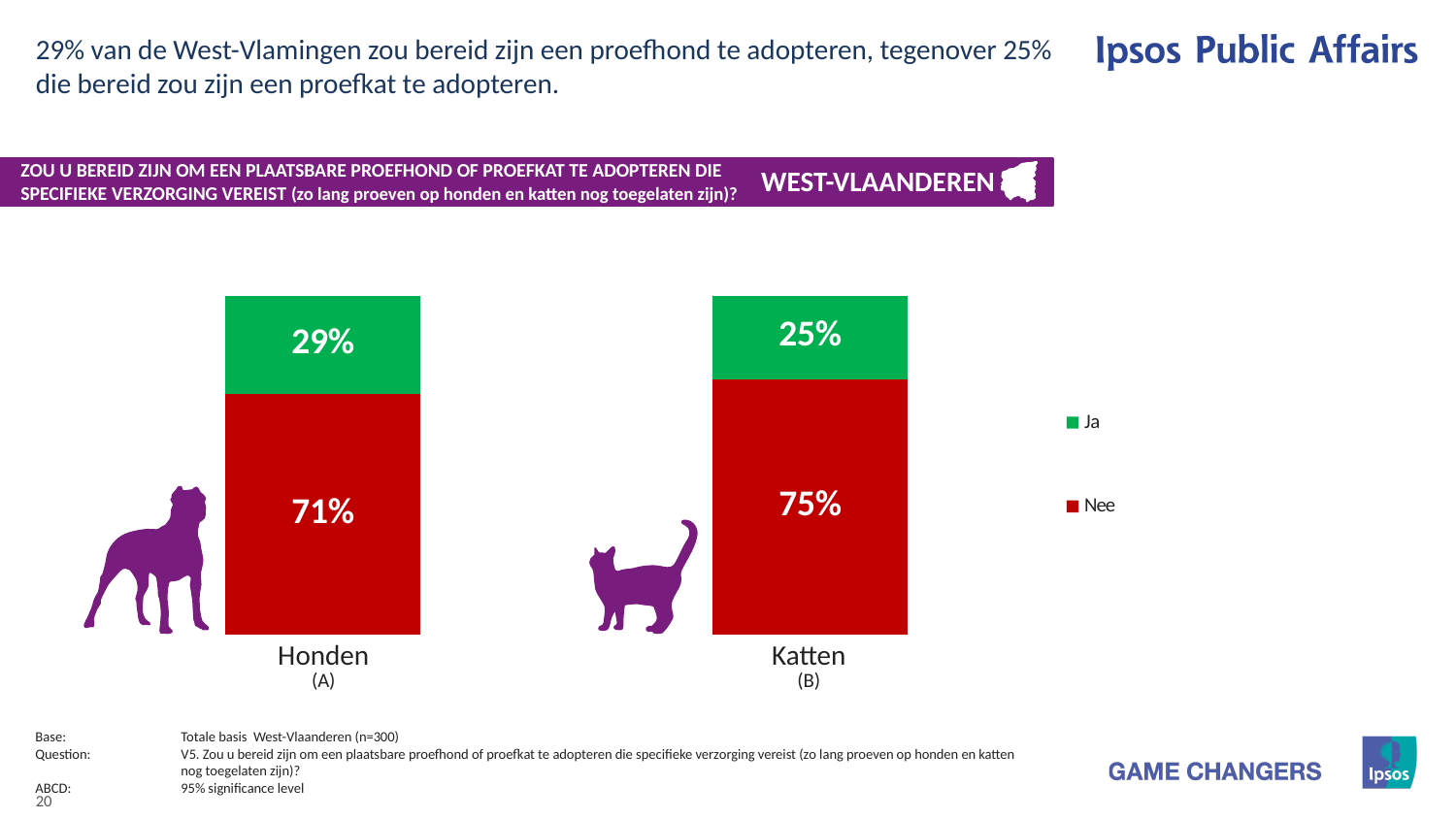
What is the 'Ja' value for Katten? 25% What percentage of respondents answered 'Nee' for Katten? 75% Which category has the highest 'Nee' value? Katten What is the difference between the 'Nee' values for Katten and Honden? 4 percentage points What percentage of respondents answered 'Ja' for Honden? 29% How many series does the legend list? 2 Which category has the higher 'Ja' share, Honden or Katten? Honden What is the total of the stacked bar for Honden? 100% How many categories are shown on the x axis? 2 What is the 'Nee' value for Honden? 71% What kind of chart is shown on the slide? Stacked bar chart What is the difference between the 'Ja' values for Honden and Katten? 4 percentage points